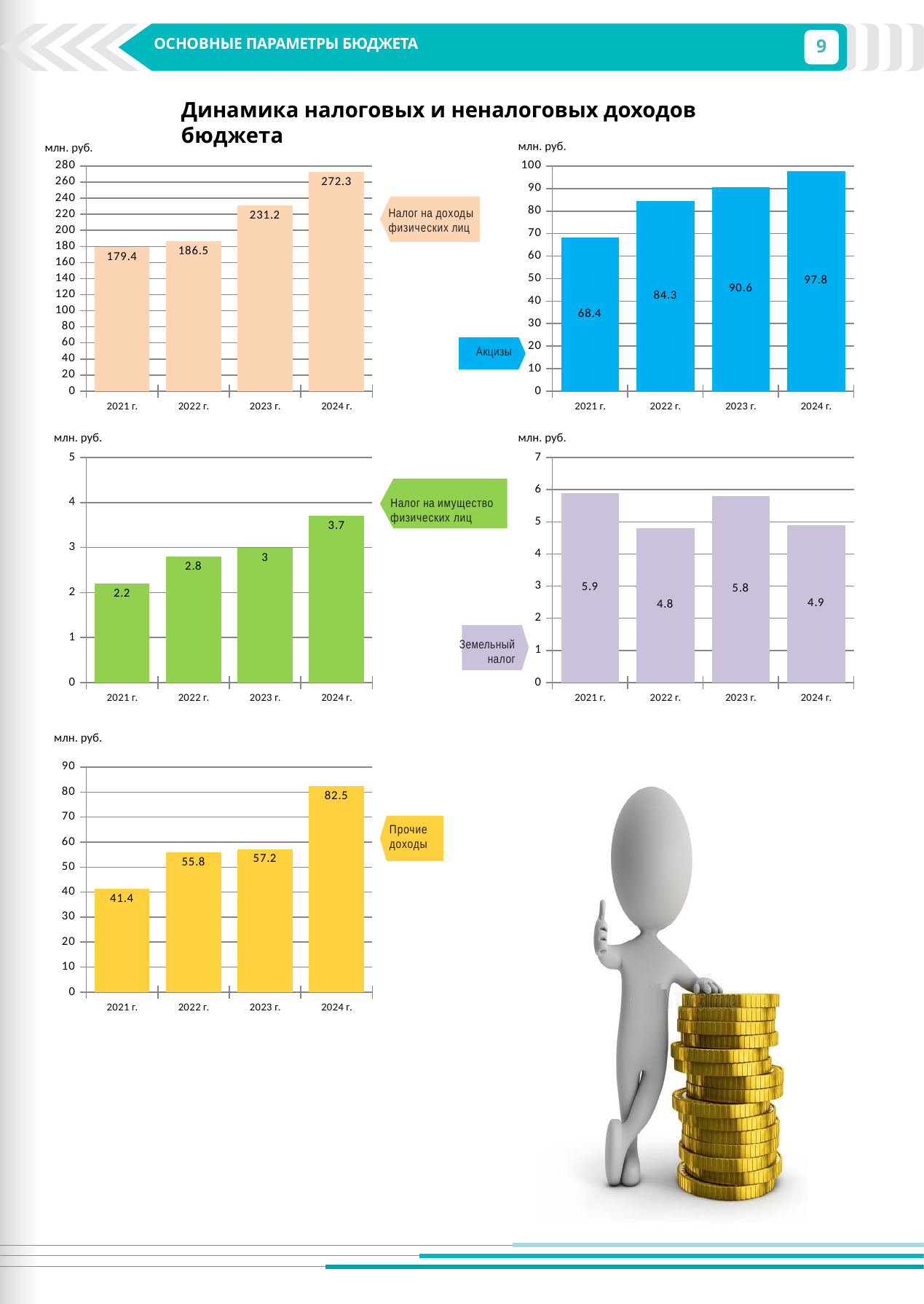
How many years are shown on the x axis of the 'Налог на доходы физических лиц' chart? 4 In the 'Налог на имущество физических лиц' chart, what is the difference between the values for 2024 г. and 2021 г.? 1.5 In the 'Акцизы' chart, what is the difference between the values for 2024 г. and 2023 г.? 7.2 In the 'Прочие доходы' chart, which year has the highest value? 2024 г. What unit is shown above the y axis of each chart on the slide? млн. руб. In the 'Земельный налог' chart, which year has the lowest value? 2022 г. In the 'Акцизы' chart, what is the value for 2021 г.? 68.4 In the 'Земельный налог' chart, which is larger: the value for 2021 г. or the value for 2023 г.? 2021 г. In the 'Налог на имущество физических лиц' chart, do the values rise or fall from 2021 г. to 2024 г.? rise In the 'Прочие доходы' chart, is the value for 2021 г. greater or less than 50? less In the 'Налог на доходы физических лиц' chart, what is the value for 2024 г.? 272.3 What kind of chart is the 'Акцизы' chart? bar chart